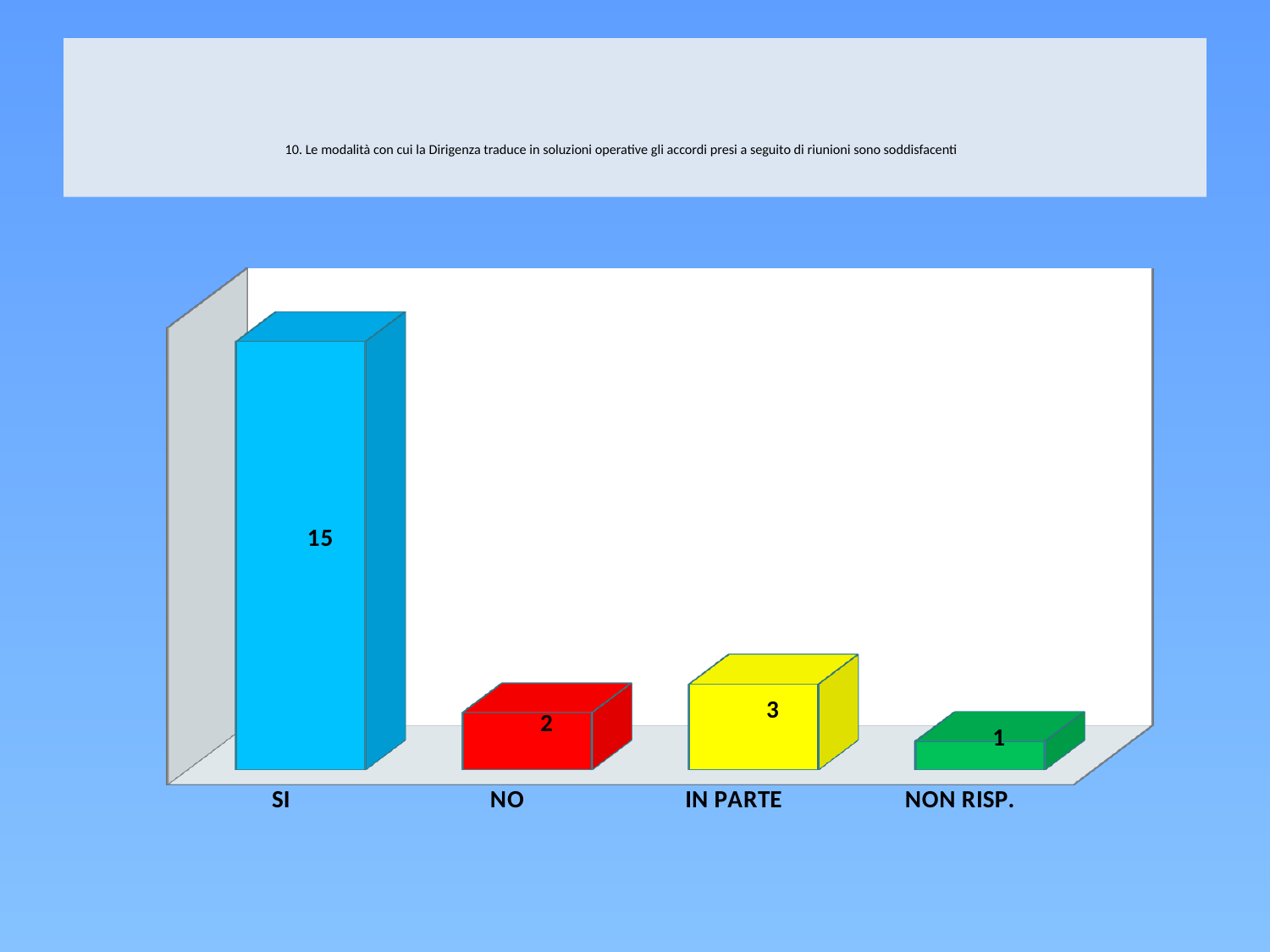
Which category has the lowest value? NON RISP. What kind of chart is shown on the slide? Bar chart What is the value for NON RISP.? 1 What is the difference between the values for SI and IN PARTE? 12 Which category has the highest value? SI What colour is the bar for SI? Light blue What is the value for SI? 15 How many categories are shown on the x axis? 4 What is the value for NO? 2 What is the difference between the values for IN PARTE and NO? 1 Which is larger, the value for NO or the value for IN PARTE? IN PARTE What is the value for IN PARTE? 3